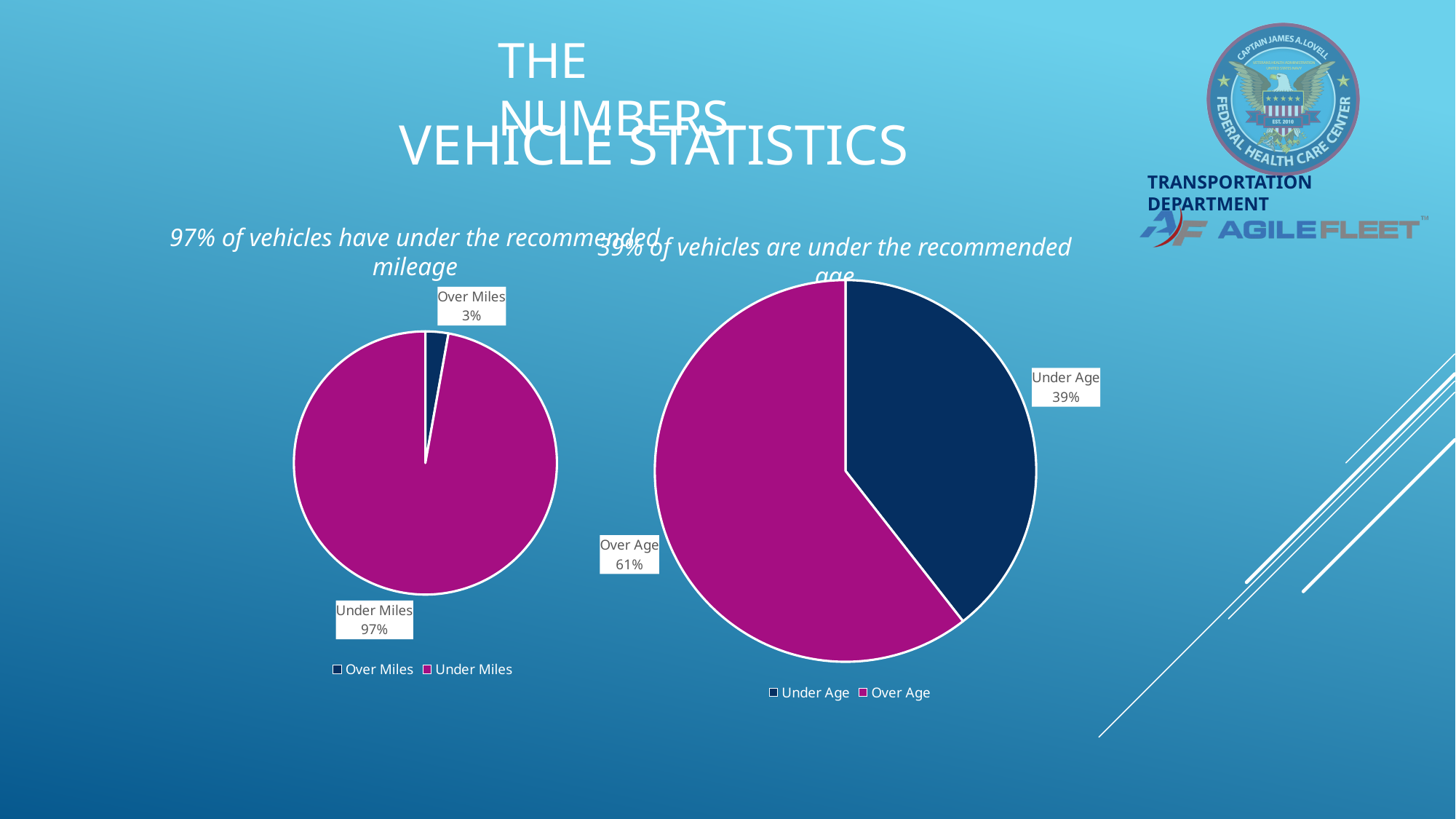
In the right pie chart, what share of vehicles is labelled Under Age? 39% In the left pie chart, which category has the smallest slice? Over Miles How many slices does the right pie chart have? 2 In the right pie chart, what share of vehicles is labelled Over Age? 61% In the left pie chart, what share of vehicles is labelled Under Miles? 97% In the left pie chart, what is the difference in percentage points between Under Miles and Over Miles? 94 In the right pie chart, which slice is larger, Under Age or Over Age? Over Age In the right pie chart, what colour is the Under Age slice? Dark blue In the right pie chart, what is the difference in percentage points between Over Age and Under Age? 22 What type of chart is used on the left of the slide? Pie chart How many entries does the legend of the left pie chart list? 2